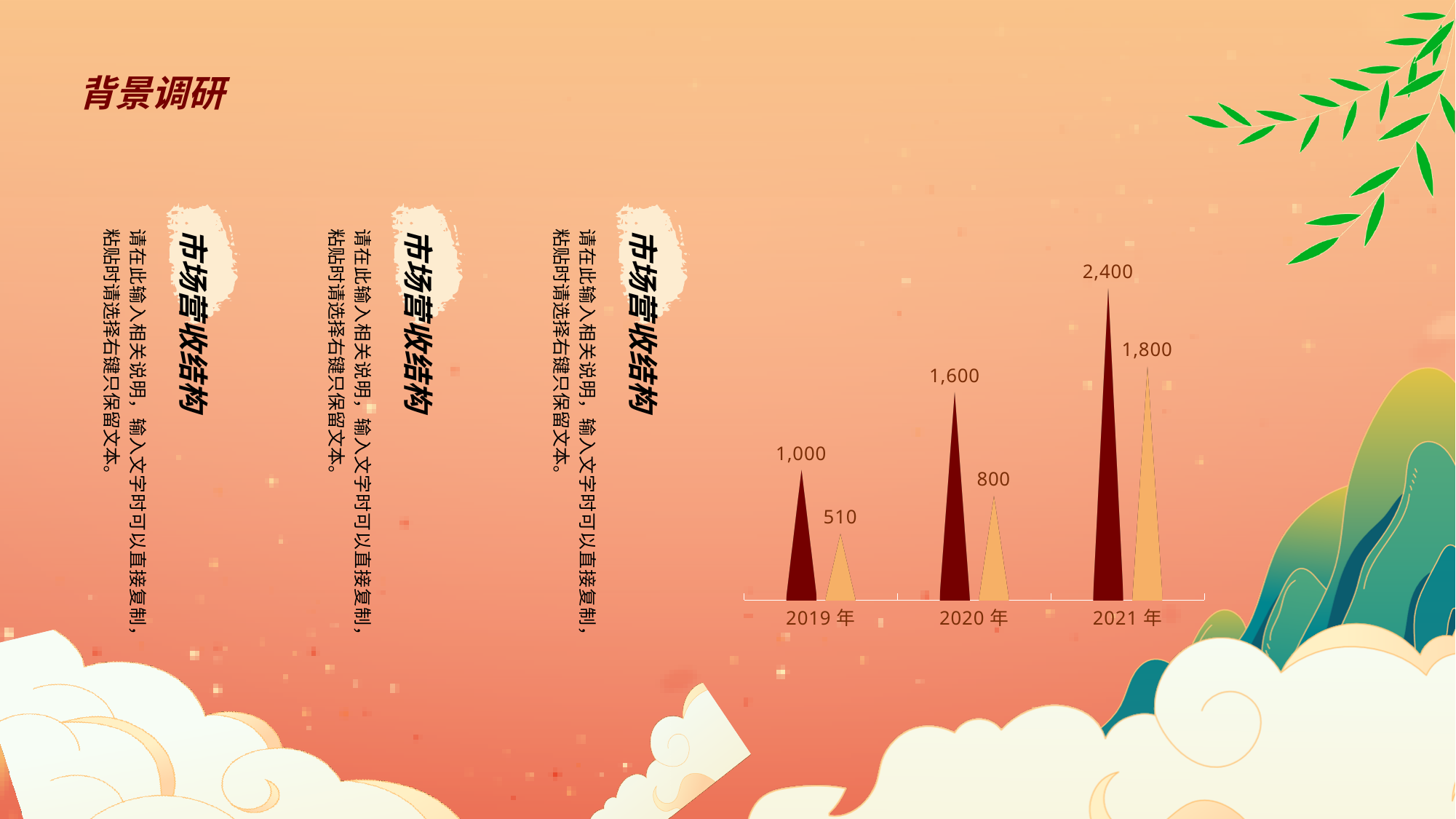
What is the value of the gold bar for 2021 年? 1,800 Which is larger, the gold bar for 2020 年 or the dark red bar for 2019 年? the dark red bar for 2019 年 Which year has the lowest gold bar? 2019 年 What is the value of the gold bar for 2019 年? 510 What is the difference between the dark red and gold bars for 2021 年? 600 Do the dark red bar values rise or fall from 2019 年 to 2021 年? rise What is the value of the dark red bar for 2020 年? 1,600 What is the value of the dark red bar for 2019 年? 1,000 What kind of chart is shown on the slide? bar chart What is the difference between the dark red bar for 2021 年 and the dark red bar for 2019 年? 1,400 Which year has the highest dark red bar? 2021 年 How many years are shown on the x axis of the chart? 3